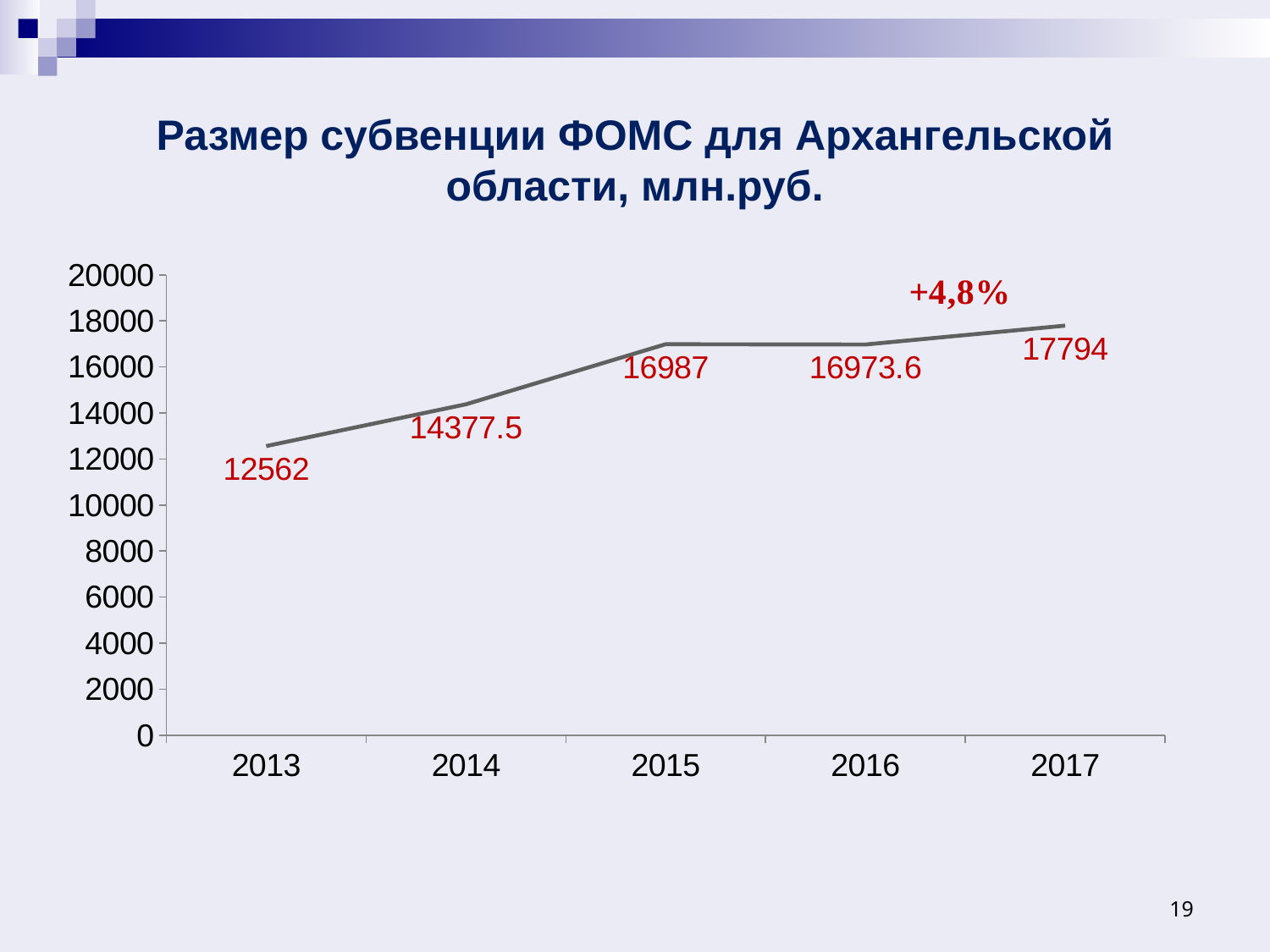
Which year has the highest value? 2017 Which is larger, the value for 2015 or the value for 2014? 2015 What is the difference between the values for 2014 and 2013? 1815.5 Which year has the lowest value? 2013 How many years are plotted on the chart? 5 What kind of chart is shown on the slide? line chart What is the value for 2017? 17794 What is the value for 2016? 16973.6 What is the value for 2013? 12562 What is the value for 2014? 14377.5 What is the difference between the values for 2017 and 2016? 820.4 What percentage change is annotated between 2016 and 2017? +4,8%